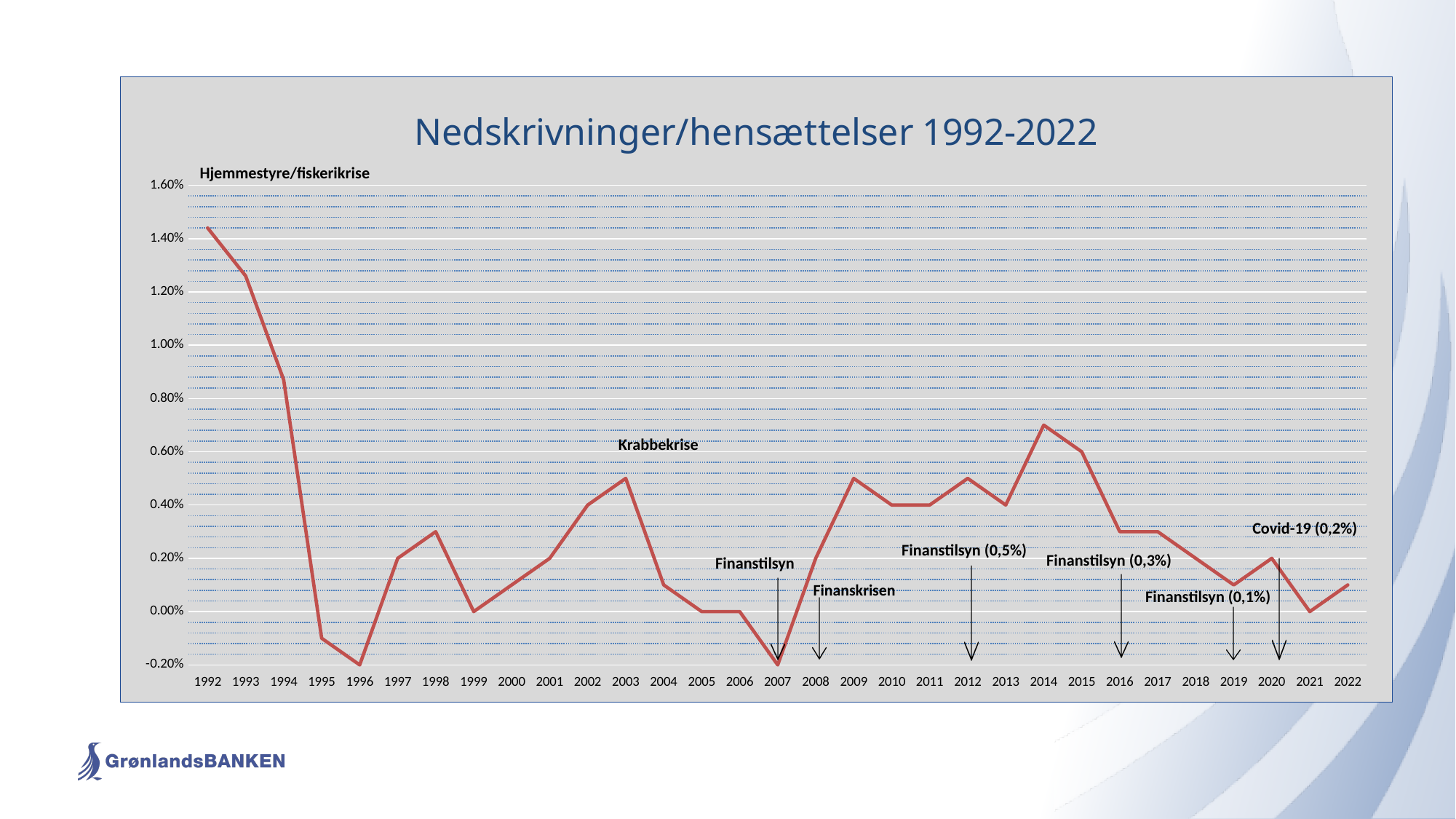
What is the value for 2007? -0.20% Which year has the highest value? 1992 What is the title of the chart? Nedskrivninger/hensættelser 1992-2022 What is the value for 2021? 0.00% What is the value for 2020? 0.20% Is the value for 1994 greater or less than 0.80%? greater Do the values rise or fall from 1992 to 1996? fall What is the difference between the values for 2020 and 2021? 0.20% What kind of chart is shown on the slide? line chart Which is larger, the value for 2014 or the value for 2015? 2014 Is the value for 2014 greater or less than 0.60%? greater How many years are plotted along the x axis? 31